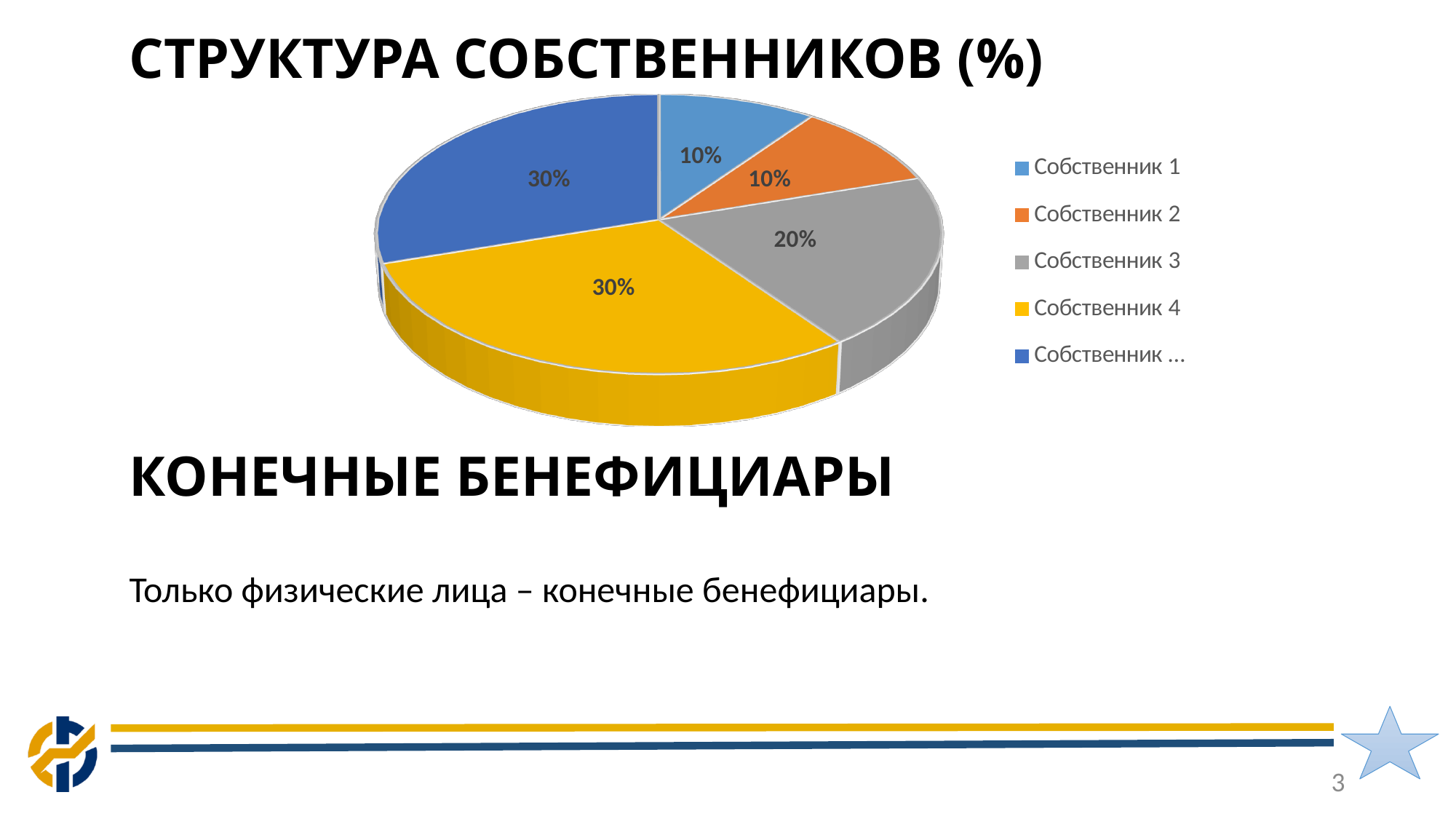
How many slices does the pie chart have? 5 What share of the pie does the slice labelled Собственник ... hold? 30% Which is larger, the share of Собственник 3 or the share of Собственник 1? Собственник 3 What is the value shown for Собственник 4? 30% What kind of chart is shown on the slide? Pie chart What is the title of the chart? СТРУКТУРА СОБСТВЕННИКОВ (%) What share of the pie does Собственник 2 hold? 10% What share of the pie does Собственник 1 hold? 10% What colour is the slice for Собственник 4? Yellow How many entries does the legend list? 5 What is the difference between the shares of Собственник 4 and Собственник 3? 10% What is the value shown for Собственник 3? 20%